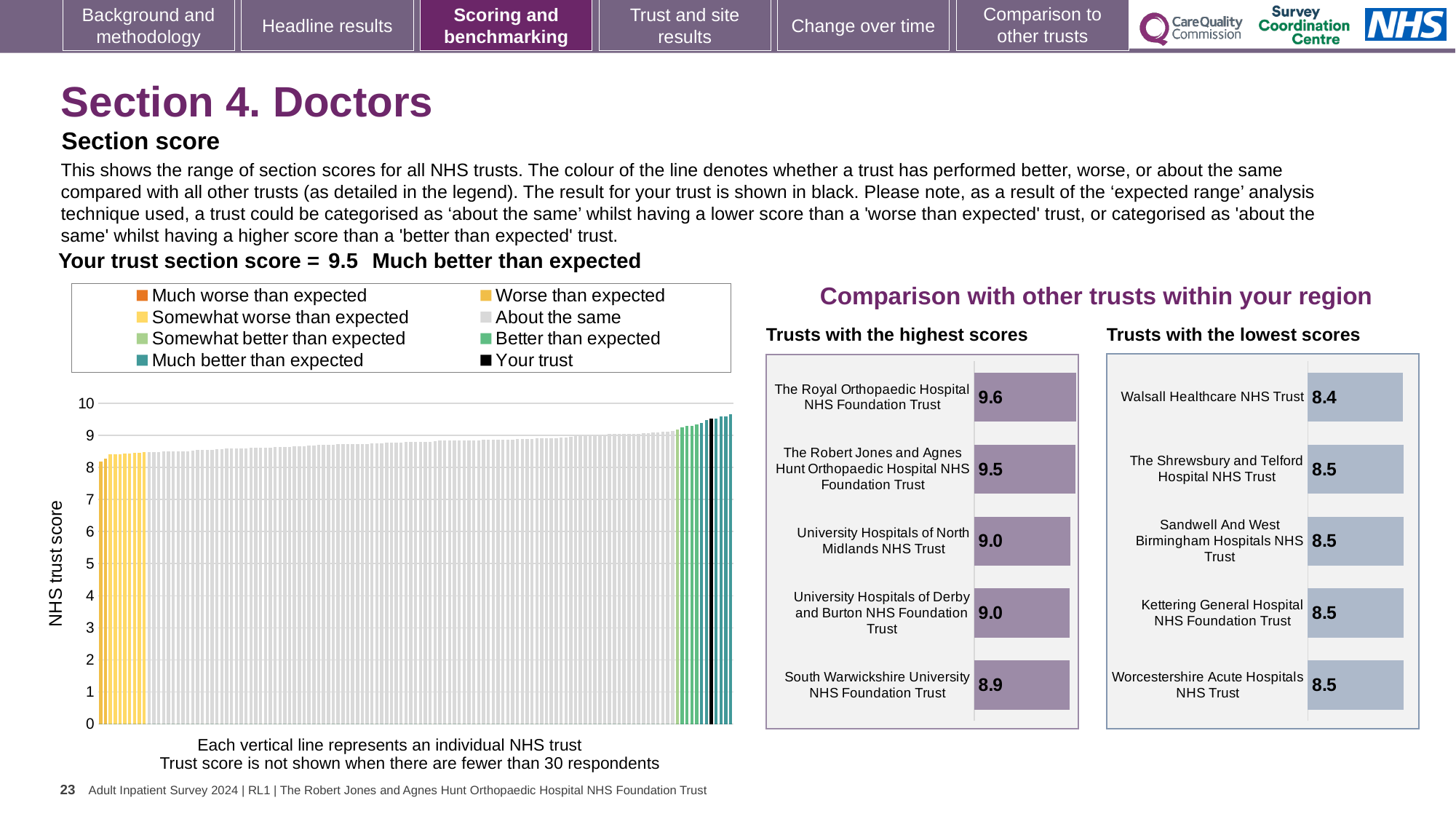
In the large chart on the left, what colour is used to show your trust? Black In the 'Trusts with the lowest scores' chart, what is the score for Walsall Healthcare NHS Trust? 8.4 How many entries does the legend of the large chart on the left list? 8 In the large chart on the left, is the value of the leftmost (lowest) trust bar greater or less than 9? less In the 'Trusts with the highest scores' chart, which trust has the highest score? The Royal Orthopaedic Hospital NHS Foundation Trust How many trusts are shown in the 'Trusts with the highest scores' chart? 5 In the 'Trusts with the highest scores' chart, what is the score for The Royal Orthopaedic Hospital NHS Foundation Trust? 9.6 According to the slide, what is your trust's section score for Doctors? 9.5 In the 'Trusts with the highest scores' chart, which has the larger score: The Robert Jones and Agnes Hunt Orthopaedic Hospital NHS Foundation Trust or University Hospitals of North Midlands NHS Trust? The Robert Jones and Agnes Hunt Orthopaedic Hospital NHS Foundation Trust In the 'Trusts with the highest scores' chart, what is the difference between the scores of The Royal Orthopaedic Hospital NHS Foundation Trust and South Warwickshire University NHS Foundation Trust? 0.7 What kind of chart is the large chart on the left showing NHS trust scores? Bar chart In the 'Trusts with the lowest scores' chart, which trust has the lowest score? Walsall Healthcare NHS Trust